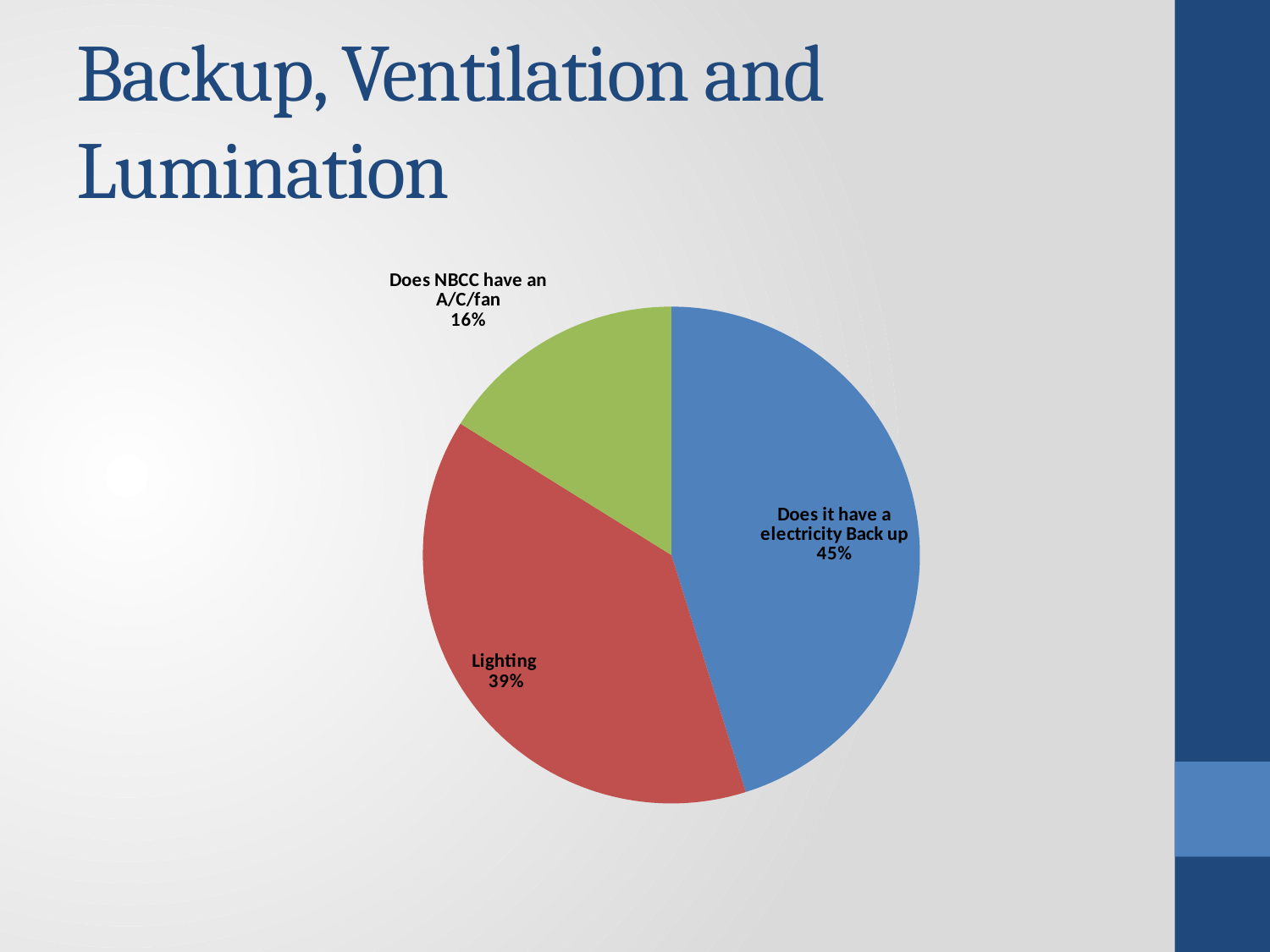
What is the title of the slide containing the pie chart? Backup, Ventilation and Lumination What is the difference in percentage points between the "Does it have a electricity Back up" slice and the "Lighting" slice? 6 What share of the pie does "Lighting" represent? 39% Which is larger: the "Lighting" slice or the "Does NBCC have an A/C/fan" slice? Lighting What is the difference in percentage points between the "Lighting" slice and the "Does NBCC have an A/C/fan" slice? 23 What kind of chart is shown on the slide? Pie chart What share of the pie does "Does NBCC have an A/C/fan" represent? 16% Which slice of the pie is the smallest? Does NBCC have an A/C/fan How many slices does the pie chart have? 3 What colour is the "Lighting" slice? Red Which slice of the pie is the largest? Does it have a electricity Back up What share of the pie does "Does it have a electricity Back up" represent? 45%